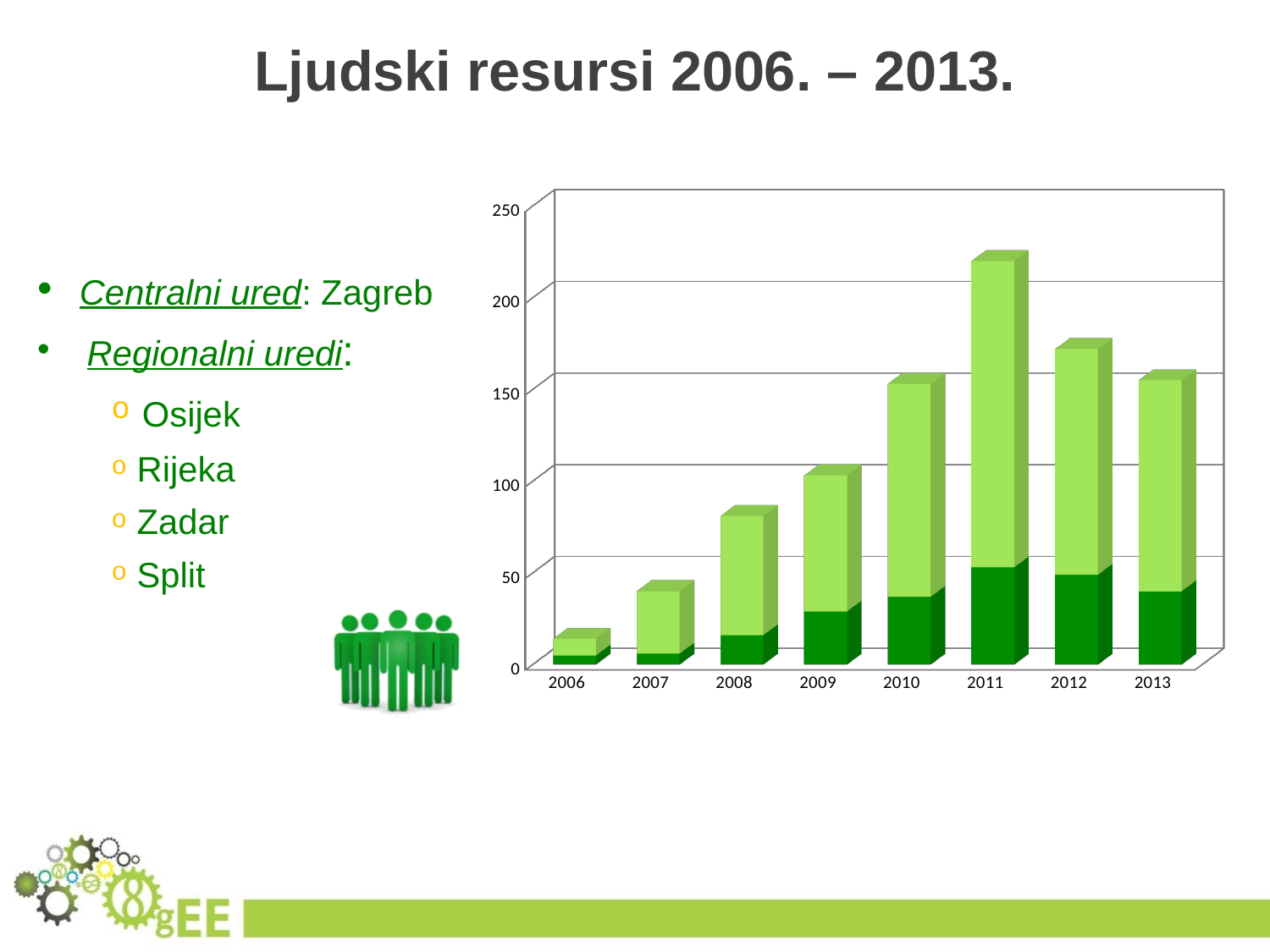
Which year has a larger total bar, 2011 or 2012? 2011 Do the total bar values rise or fall from 2006 to 2011? rise Is the total value for 2011 greater or less than 200? greater Which year has a larger total bar, 2008 or 2009? 2009 Which year has the lowest total bar in the chart? 2006 How many years are shown on the x axis of the chart? 8 Is the total value for 2012 greater or less than 150? greater Which year has the highest total bar in the chart? 2011 How many coloured segments does each bar in the chart have? 2 What kind of chart is shown on the slide? Stacked bar chart Is the total value for 2006 greater or less than 50? less